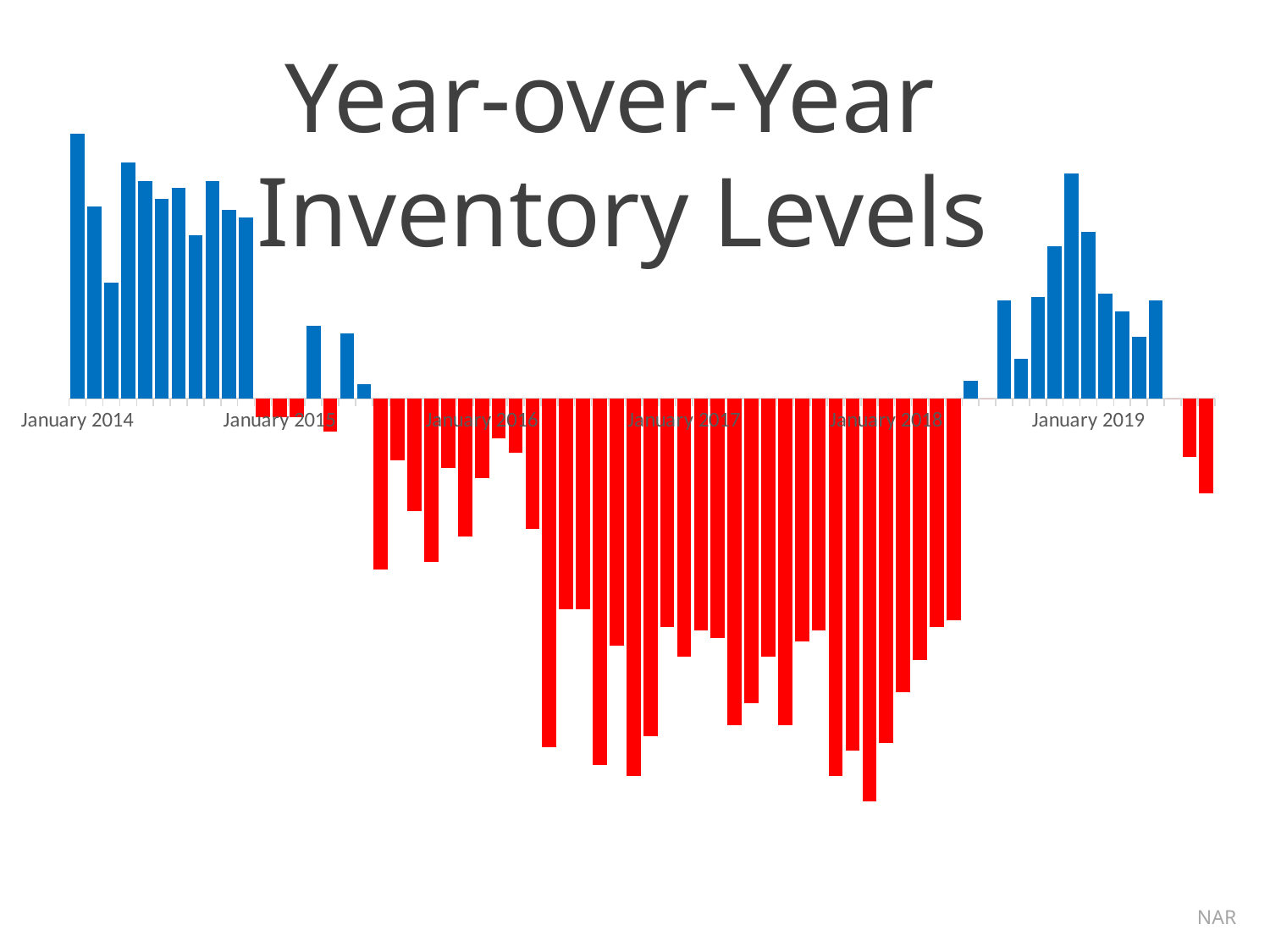
Which of the labelled Januaries on the x axis has the highest value? January 2014 What kind of chart is shown on the slide? bar chart Which is larger, the value for January 2015 or the value for January 2016? January 2015 Do the values rise or fall from January 2014 to January 2015? fall Which is larger, the value for January 2019 or the value for January 2018? January 2019 Do the values rise or fall from January 2018 to January 2019? rise How many January labels appear on the x axis of the chart? 6 What is the title of the chart? Year-over-Year Inventory Levels Which is larger, the value for January 2014 or the value for January 2017? January 2014 What colour are the bars with negative values in the chart? red